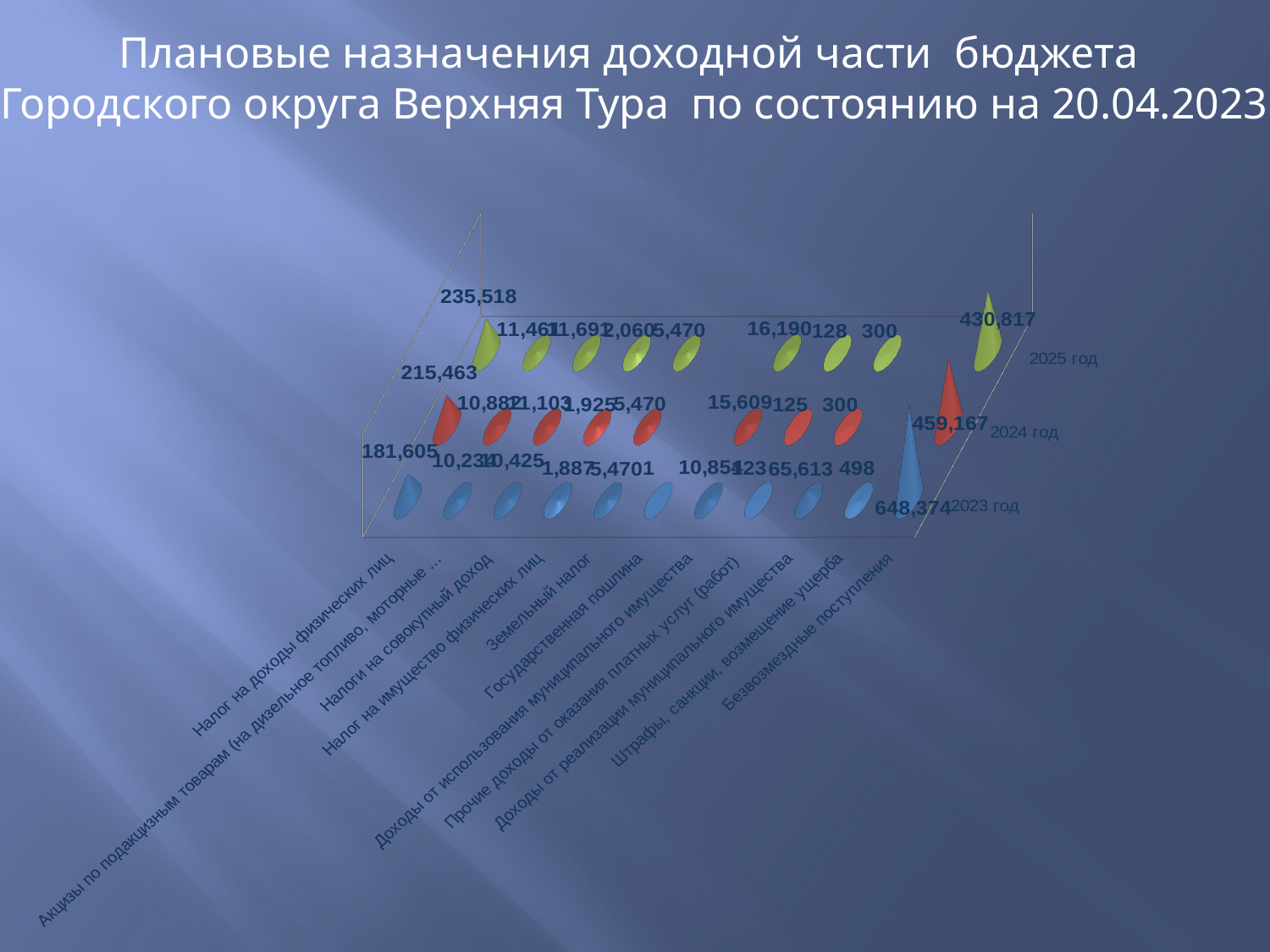
What colour represents the 2024 год series? red Which is larger: Налог на доходы физических лиц in 2023 год or in 2025 год? 2025 год Which category has the highest value in 2023 год? Безвозмездные поступления What is the value for Налог на доходы физических лиц in 2025 год? 235,518 How many years (series) are plotted on the chart? 3 What is the value for Доходы от использования муниципального имущества in 2024 год? 15,609 What is the difference between Безвозмездные поступления in 2023 год (648,374) and in 2025 год (430,817)? 217,557 What is the value for Земельный налог in 2025 год? 5,470 What is the value for Безвозмездные поступления in 2023 год? 648,374 How many revenue categories are shown along the category axis? 11 Does the value for Безвозмездные поступления rise or fall from 2023 год to 2025 год? fall What is the difference between Налог на доходы физических лиц in 2025 год (235,518) and in 2023 год (181,605)? 53,913